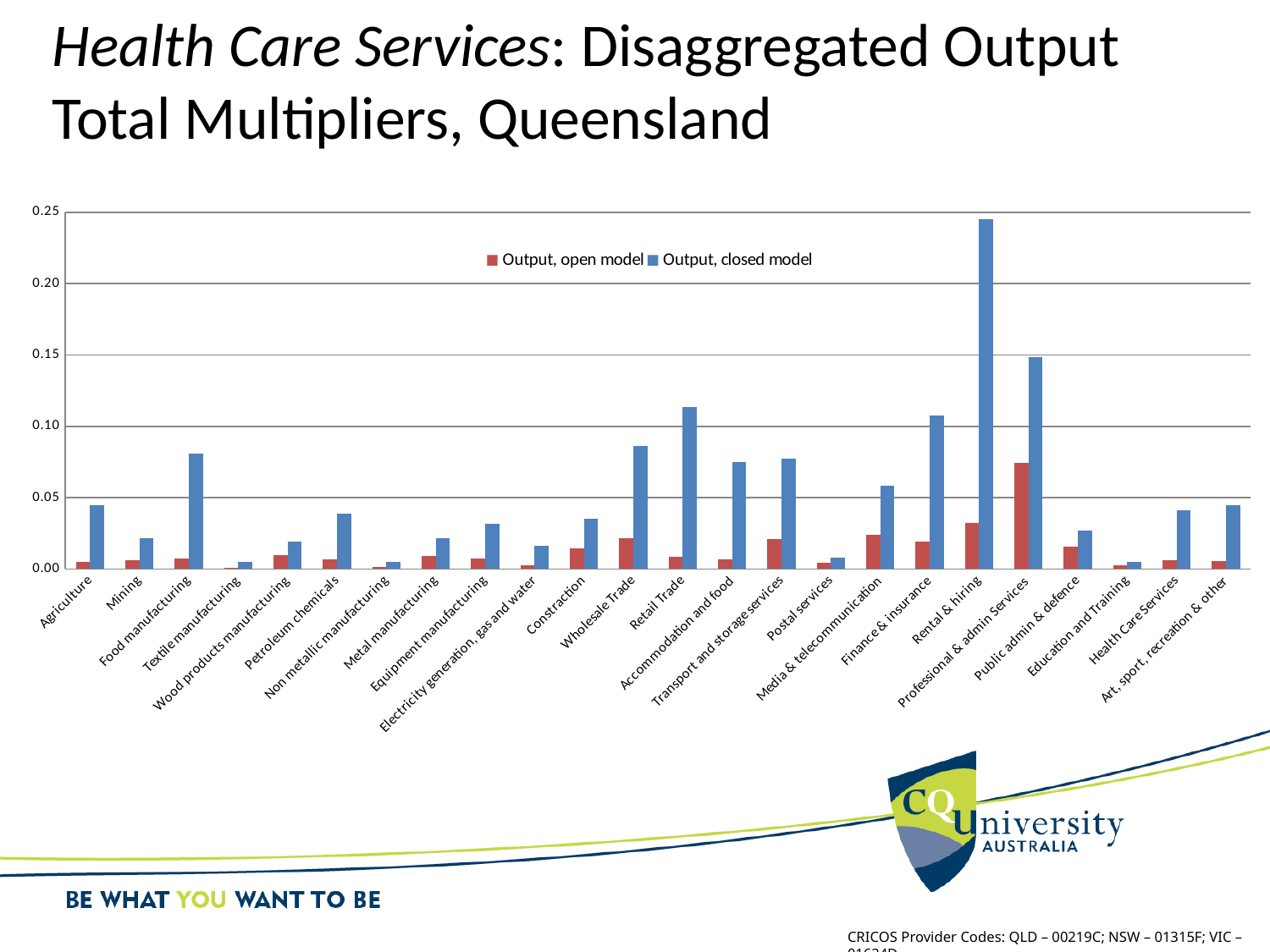
Which category has the highest value for the Output, open model series? Professional & admin Services Is the Output, open model value for Professional & admin Services greater or less than 0.05? greater For the Output, closed model series, which is larger: Retail Trade or Wholesale Trade? Retail Trade How many industry categories are shown on the x axis? 24 Which category has the highest value for the Output, closed model series? Rental & hiring Is the Output, closed model value for Food manufacturing greater or less than 0.05? greater What kind of chart is shown on the slide? Bar chart How many series does the legend list? 2 Is the Output, closed model value for Rental & hiring greater or less than 0.20? greater What colour are the bars for the Output, closed model series? Blue For the Output, closed model series, which is larger: Mining or Food manufacturing? Food manufacturing